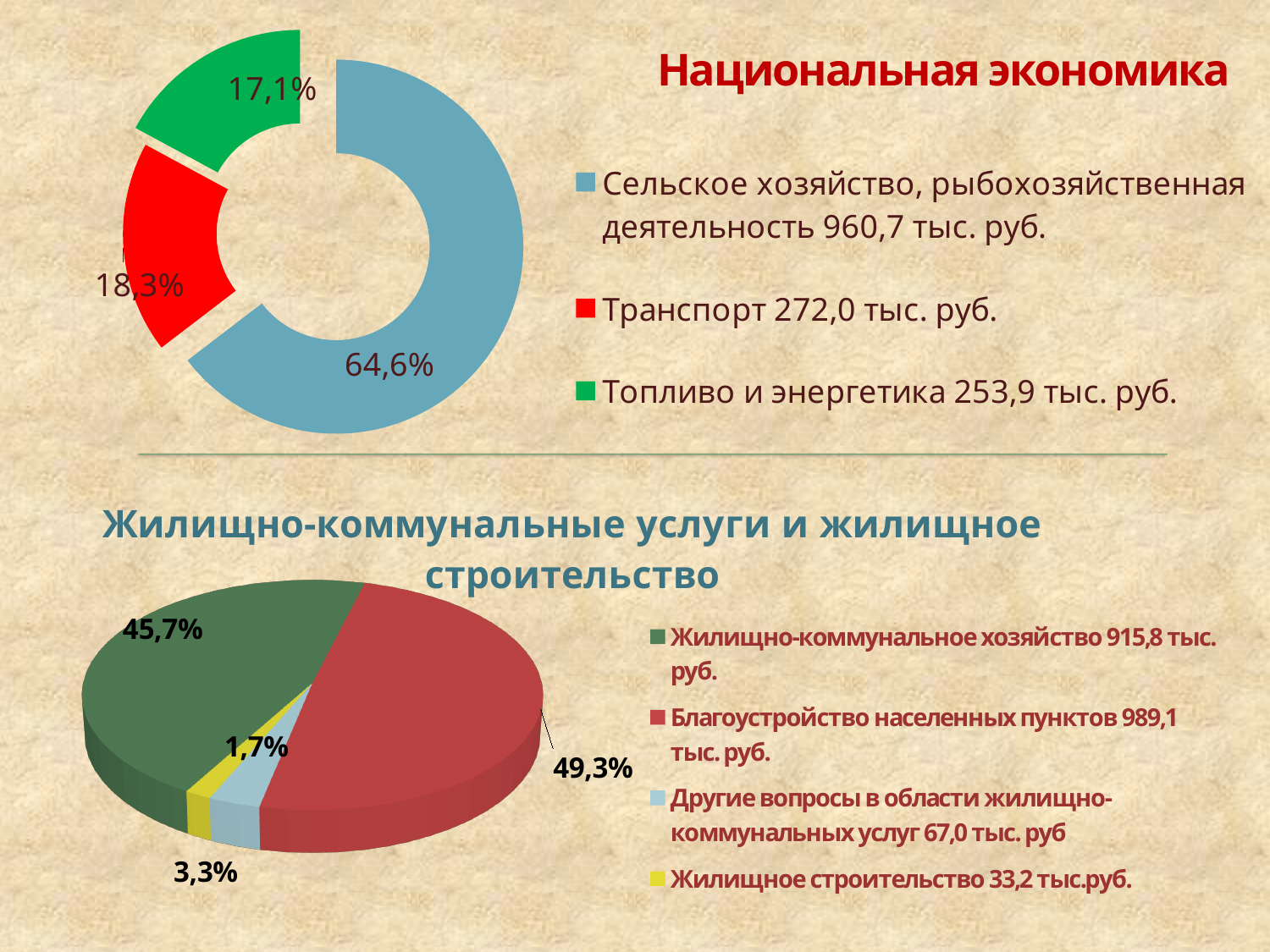
In the 'Жилищно-коммунальные услуги и жилищное строительство' chart, how many categories does the legend list? 4 In the 'Национальная экономика' chart, what percentage is shown for 'Транспорт'? 18,3% In the 'Жилищно-коммунальные услуги и жилищное строительство' chart, which is larger: 'Жилищно-коммунальное хозяйство' or 'Благоустройство населенных пунктов'? Благоустройство населенных пунктов In the 'Жилищно-коммунальные услуги и жилищное строительство' chart, what percentage is shown for 'Жилищно-коммунальное хозяйство'? 45,7% In the 'Национальная экономика' chart, what amount in тыс. руб. is given in the legend for 'Транспорт'? 272,0 тыс. руб. What kind of chart is the 'Жилищно-коммунальные услуги и жилищное строительство' chart? pie chart In the 'Национальная экономика' chart, what is the difference in percentage points between 'Транспорт' and 'Топливо и энергетика'? 1,2 In the 'Национальная экономика' chart, which category has the largest share? Сельское хозяйство, рыбохозяйственная деятельность In the 'Жилищно-коммунальные услуги и жилищное строительство' chart, what share does 'Благоустройство населенных пунктов' have? 49,3% In the 'Национальная экономика' chart, how many categories are shown? 3 In the 'Национальная экономика' chart, what share does 'Сельское хозяйство, рыбохозяйственная деятельность' have? 64,6% In the 'Национальная экономика' chart, what percentage is shown for 'Топливо и энергетика'? 17,1%